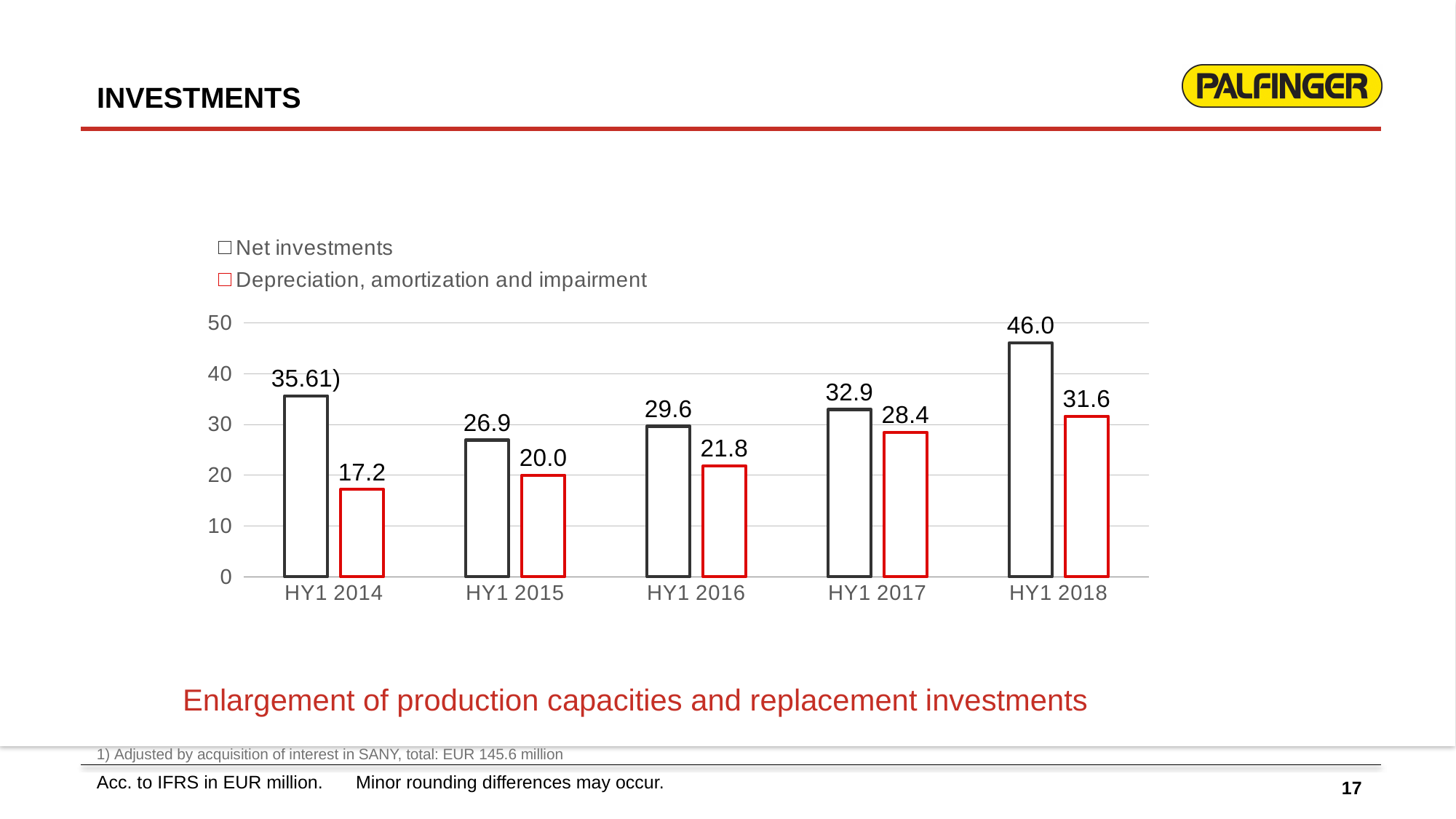
What is the value of Depreciation, amortization and impairment for HY1 2017? 28.4 What is the value of Depreciation, amortization and impairment for HY1 2014? 17.2 What is the difference between Net investments and Depreciation, amortization and impairment in HY1 2018? 14.4 What is the value of Net investments for HY1 2018? 46.0 What is the value of Net investments for HY1 2016? 29.6 How many series does the legend list? 2 How many periods are shown on the x axis? 5 In which period is Net investments highest? HY1 2018 Which is larger in HY1 2015: Net investments or Depreciation, amortization and impairment? Net investments In which period is Net investments lowest? HY1 2015 In which period is Depreciation, amortization and impairment lowest? HY1 2014 What kind of chart is shown on the slide? Bar chart